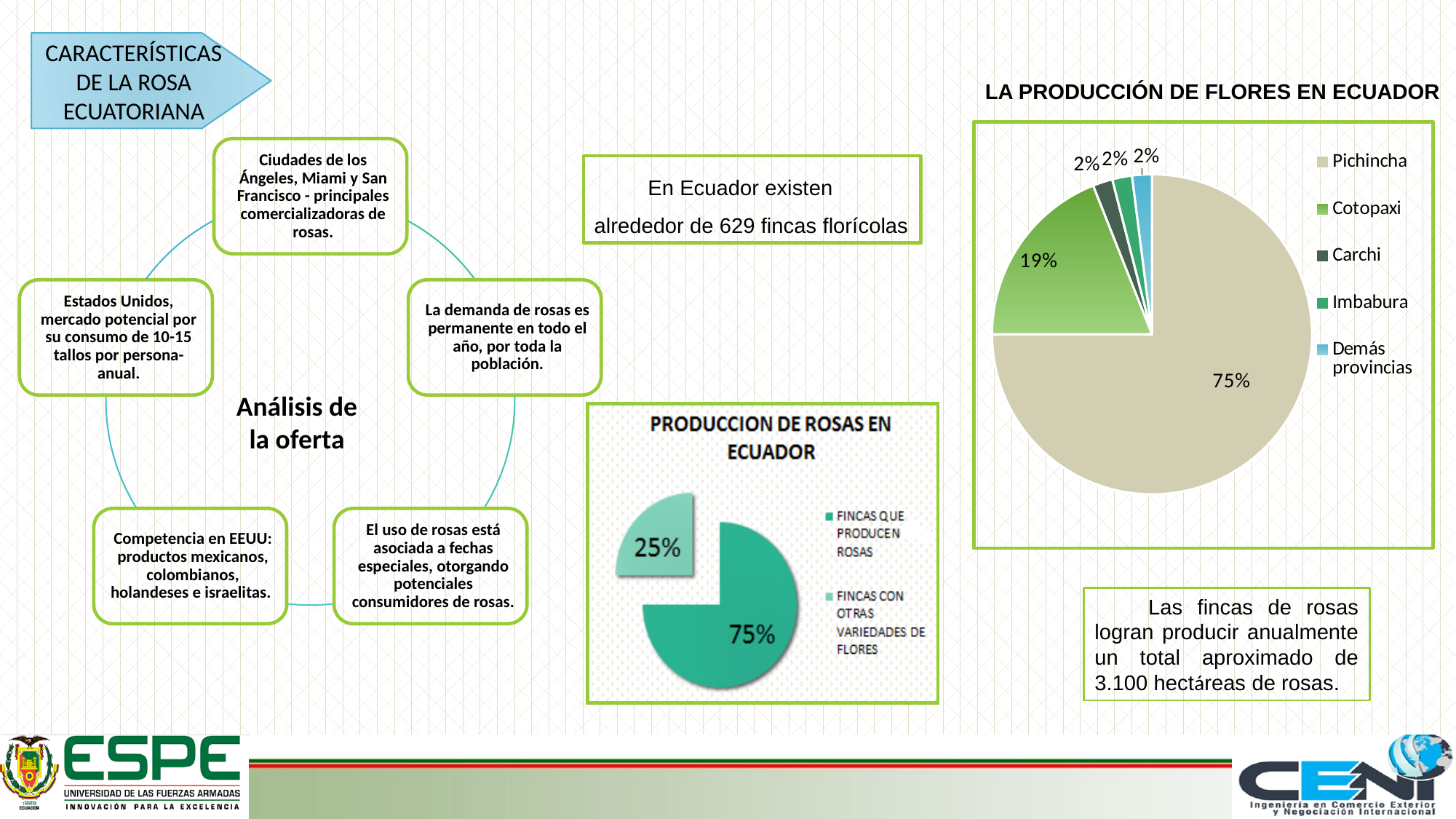
In the chart titled 'LA PRODUCCIÓN DE FLORES EN ECUADOR', what share does Pichincha have? 75% In the chart titled 'LA PRODUCCIÓN DE FLORES EN ECUADOR', what is the difference between the shares of Pichincha and Cotopaxi? 56% In the chart titled 'LA PRODUCCIÓN DE FLORES EN ECUADOR', which province has the largest share? Pichincha In the chart titled 'PRODUCCION DE ROSAS EN ECUADOR', which category has the smaller share? FINCAS CON OTRAS VARIEDADES DE FLORES In the chart titled 'PRODUCCION DE ROSAS EN ECUADOR', how many slices does the pie have? 2 What kind of chart is 'LA PRODUCCIÓN DE FLORES EN ECUADOR'? Pie chart In the chart titled 'LA PRODUCCIÓN DE FLORES EN ECUADOR', what share does Carchi have? 2% In the chart titled 'LA PRODUCCIÓN DE FLORES EN ECUADOR', which is larger, the share of Cotopaxi or the share of Imbabura? Cotopaxi In the chart titled 'LA PRODUCCIÓN DE FLORES EN ECUADOR', what share does Cotopaxi have? 19% In the chart titled 'PRODUCCION DE ROSAS EN ECUADOR', what share is 'FINCAS QUE PRODUCEN ROSAS'? 75% In the chart titled 'LA PRODUCCIÓN DE FLORES EN ECUADOR', how many categories does the legend list? 5 In the chart titled 'PRODUCCION DE ROSAS EN ECUADOR', what share is 'FINCAS CON OTRAS VARIEDADES DE FLORES'? 25%